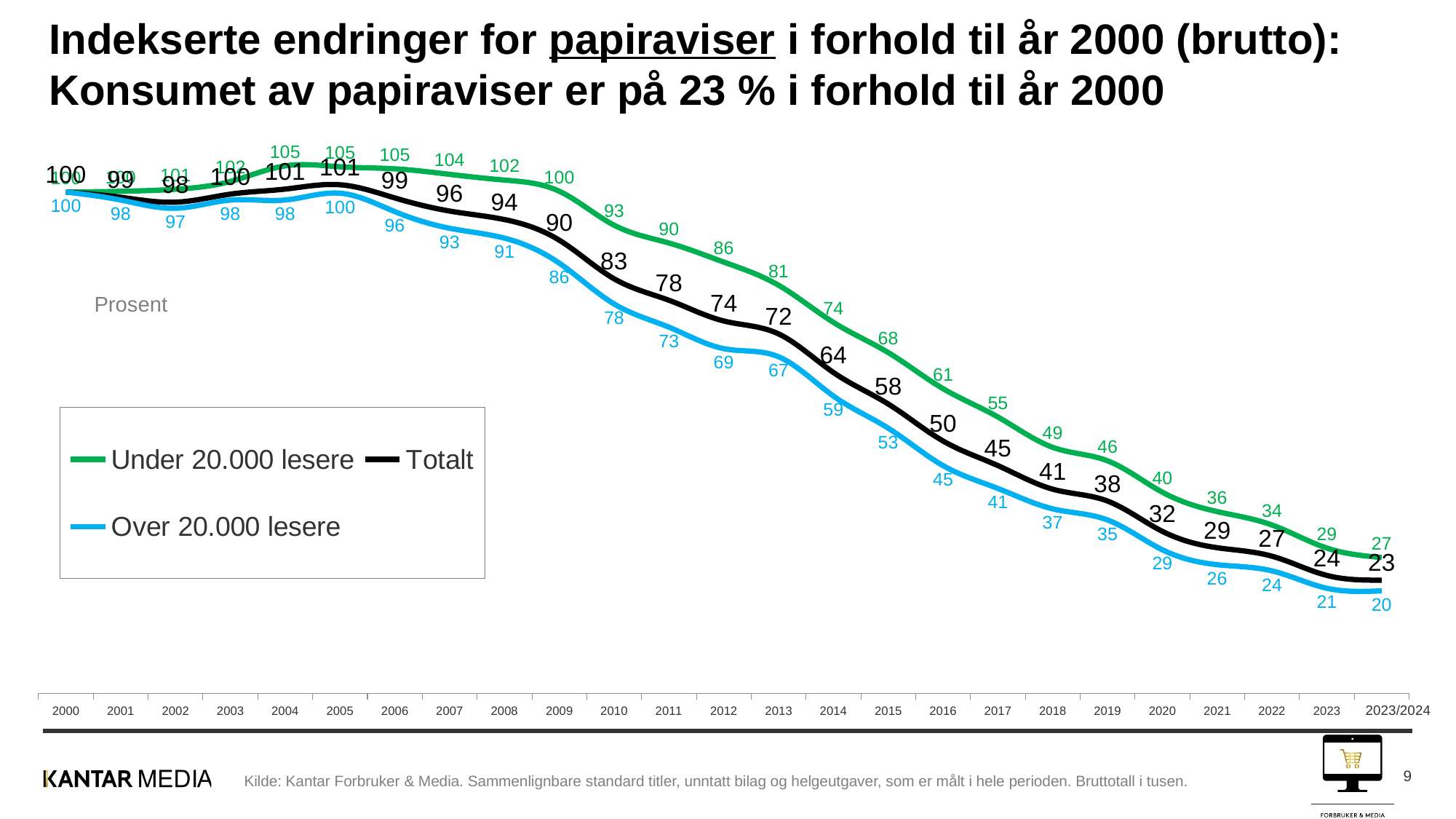
What is the value of the Totalt series in 2014? 64 Which series has the higher value in 2020: Under 20.000 lesere or Over 20.000 lesere? Under 20.000 lesere What is the value of the Totalt series for 2023/2024? 23 Which colour is used for the Totalt series? Black What is the overall trend of the Totalt series from 2005 to 2023/2024? Falling What type of chart is shown on the slide? Line chart How many series does the legend list? 3 In which year does the Over 20.000 lesere series reach its lowest value? 2023/2024 What is the value of the Under 20.000 lesere series in 2010? 93 How many points are plotted along the x axis for each series? 25 What is the value of the Over 20.000 lesere series in 2016? 45 What is the difference between the Under 20.000 lesere value and the Over 20.000 lesere value in 2015? 15